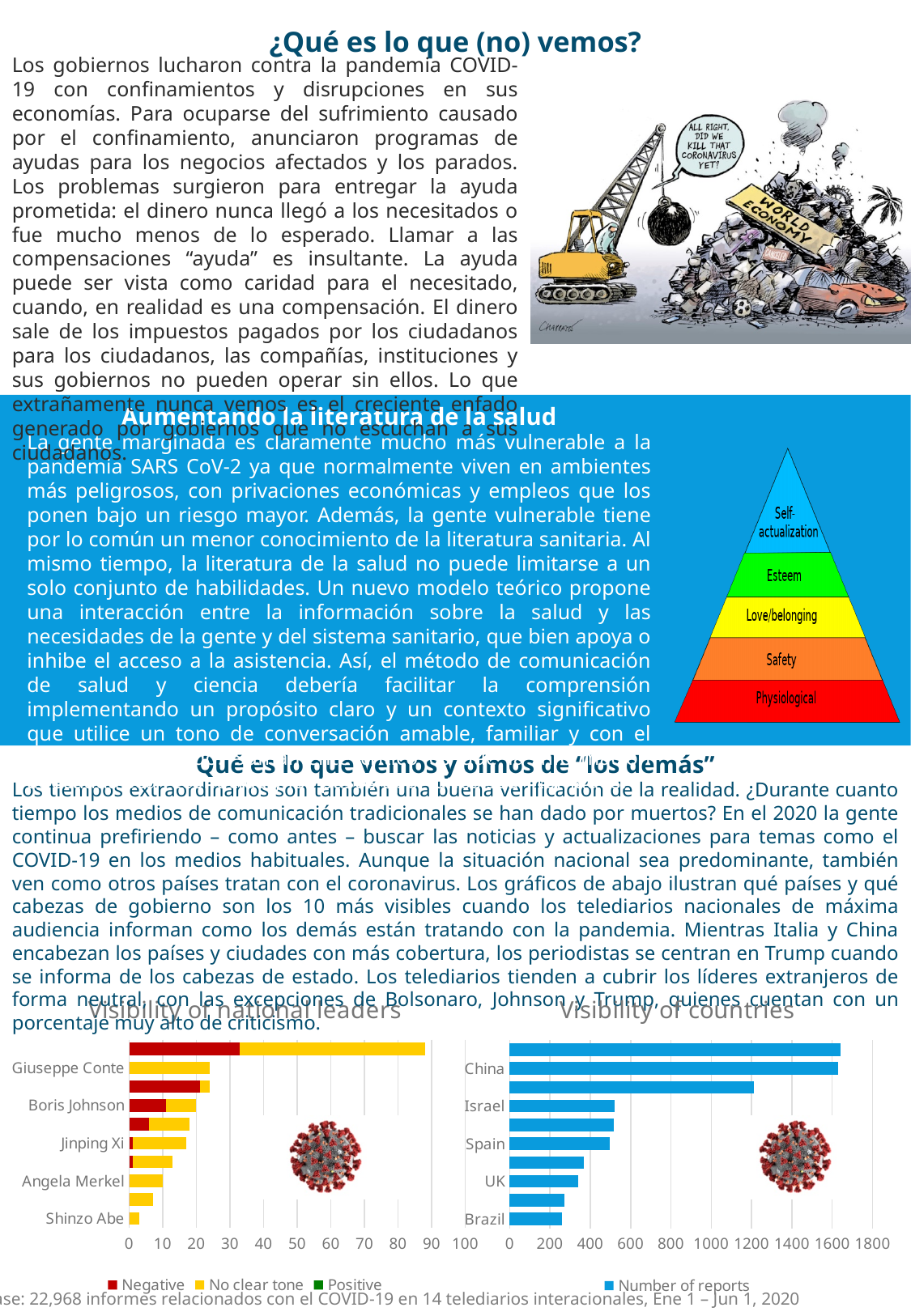
In the "Visibility of countries" chart, which has more reports, China or Brazil? China In the "Visibility of countries" chart, is the value for Israel greater or less than 400? greater What kind of chart is "Visibility of countries"? bar chart In the "Visibility of national leaders" chart, what are the legend entries? Negative, No clear tone, Positive In the "Visibility of national leaders" chart, is the total bar length for Shinzo Abe greater or less than 20? less In the "Visibility of countries" chart, is the value for China greater or less than 1400? greater In the "Visibility of countries" chart, what is the name of the series shown in the legend? Number of reports In the "Visibility of national leaders" chart, how many series does the legend list? 3 In the "Visibility of national leaders" chart, which leader has the longer total bar, Giuseppe Conte or Shinzo Abe? Giuseppe Conte What kind of chart is "Visibility of national leaders"? bar chart In the "Visibility of countries" chart, how many bars are plotted? 10